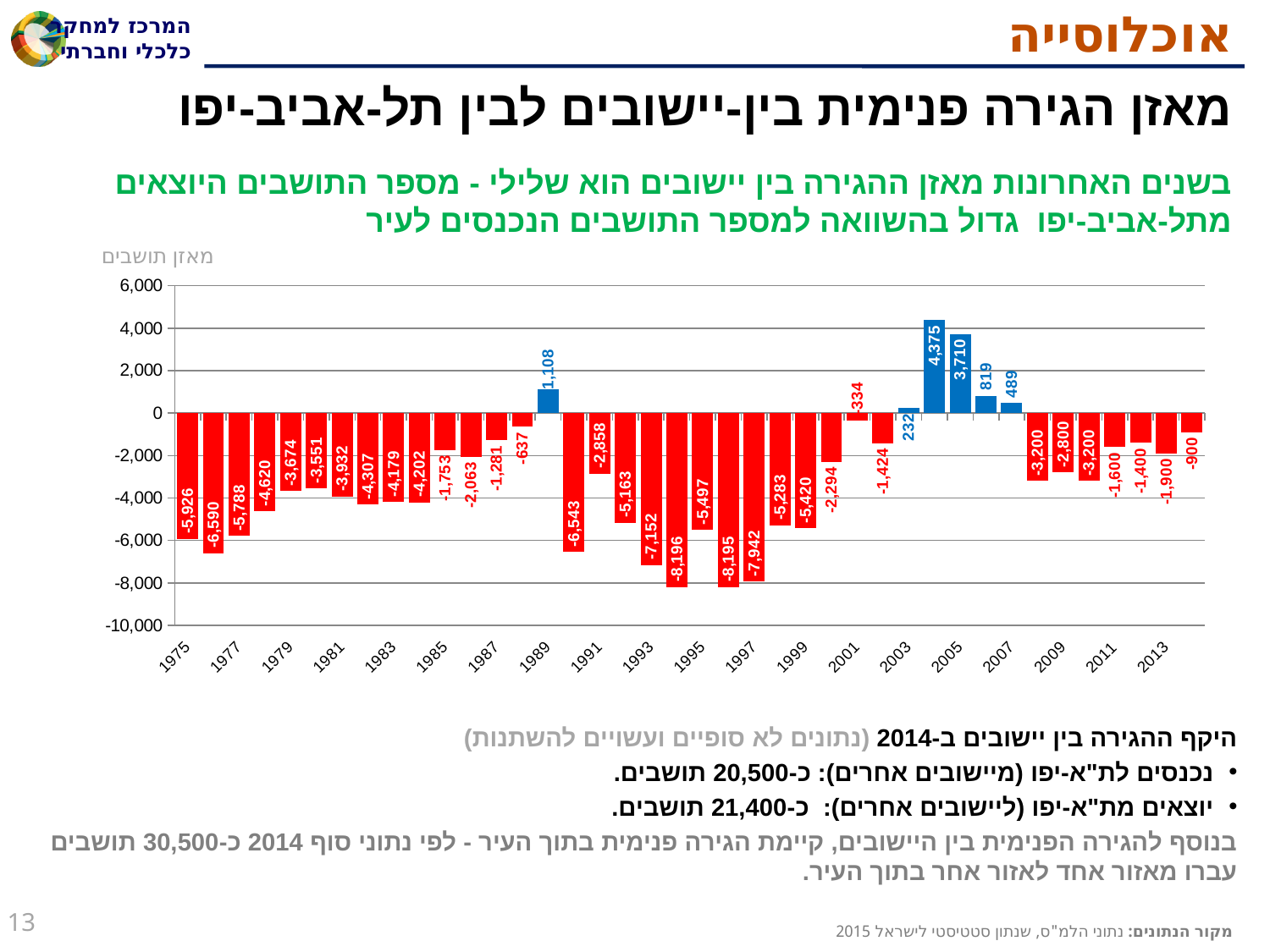
What is the migration balance value shown for 2001? -334 What is the label shown above the vertical axis of the chart? מאזן תושבים What is the migration balance value shown for 2005? 3,710 What kind of chart is shown on the slide? bar chart What is the migration balance value shown for 1975? -5,926 What is the migration balance value shown for 2013? -1,900 How many years (bars) are plotted in the chart? 40 Which year has the highest migration balance in the chart? 2004 What is the difference between the values for 2004 (4,375) and 2005 (3,710)? 665 What is the migration balance value shown for 1989? 1,108 Is the value for 1977 greater or less than -4,000? less Which is larger, the value for 1989 or the value for 2003? 1989